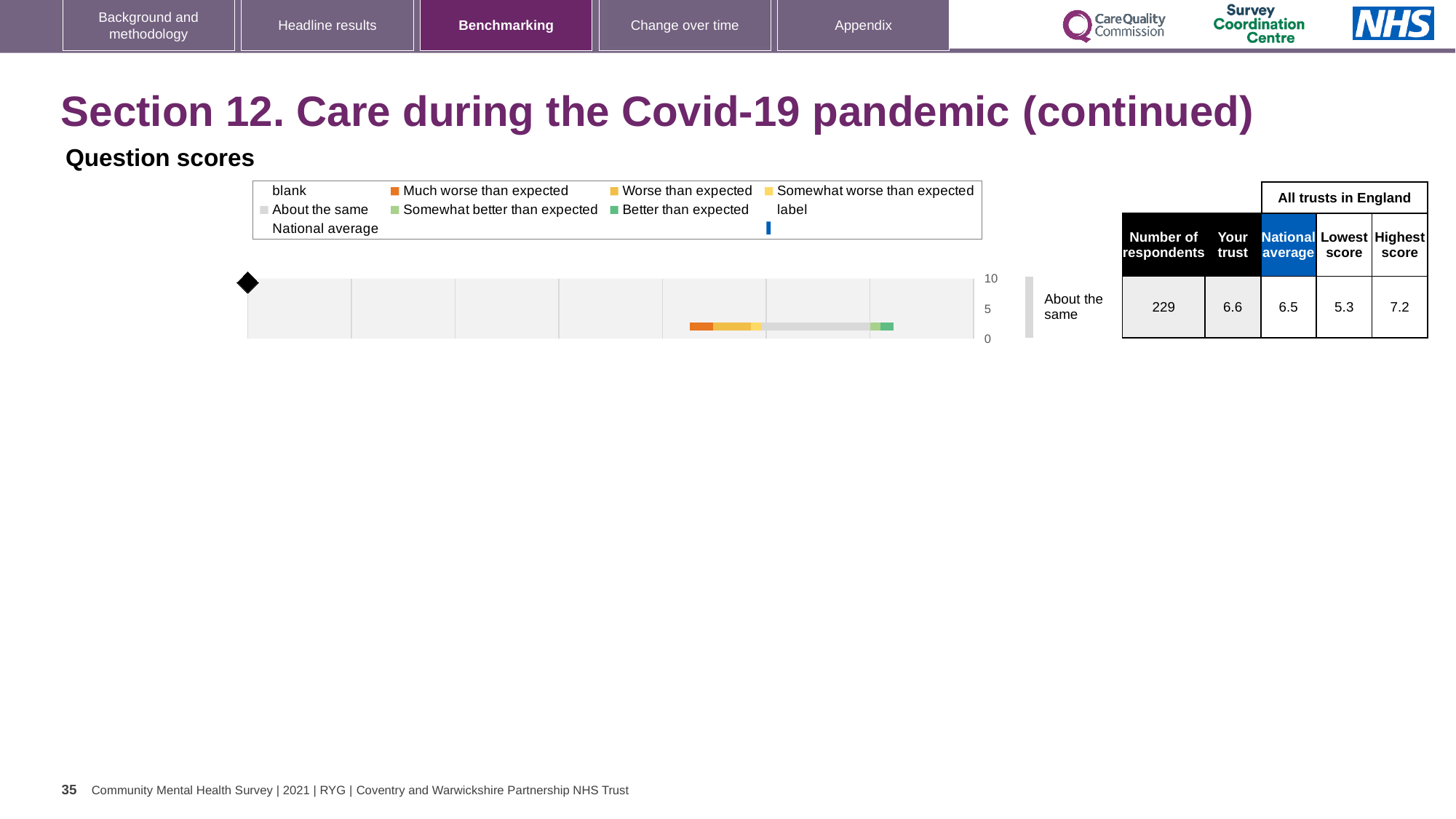
What colour does the legend use for 'Much worse than expected'? orange What is the score for Your trust shown in the table next to the chart? 6.6 How many question rows are plotted in the chart? 1 What is the Lowest score among all trusts in England shown in the table? 5.3 How many respondents are listed for this question? 229 What is the National average score shown in the table? 6.5 Which is larger, the Your trust score or the National average score? Your trust What is the difference between the Highest score and the Lowest score in the table? 1.9 What is the Highest score among all trusts in England shown in the table? 7.2 What is the difference between the Your trust score and the National average score? 0.1 What benchmark category label is shown next to the chart for this question? About the same What kind of chart is used to show the question score benchmarking on this slide? bar chart